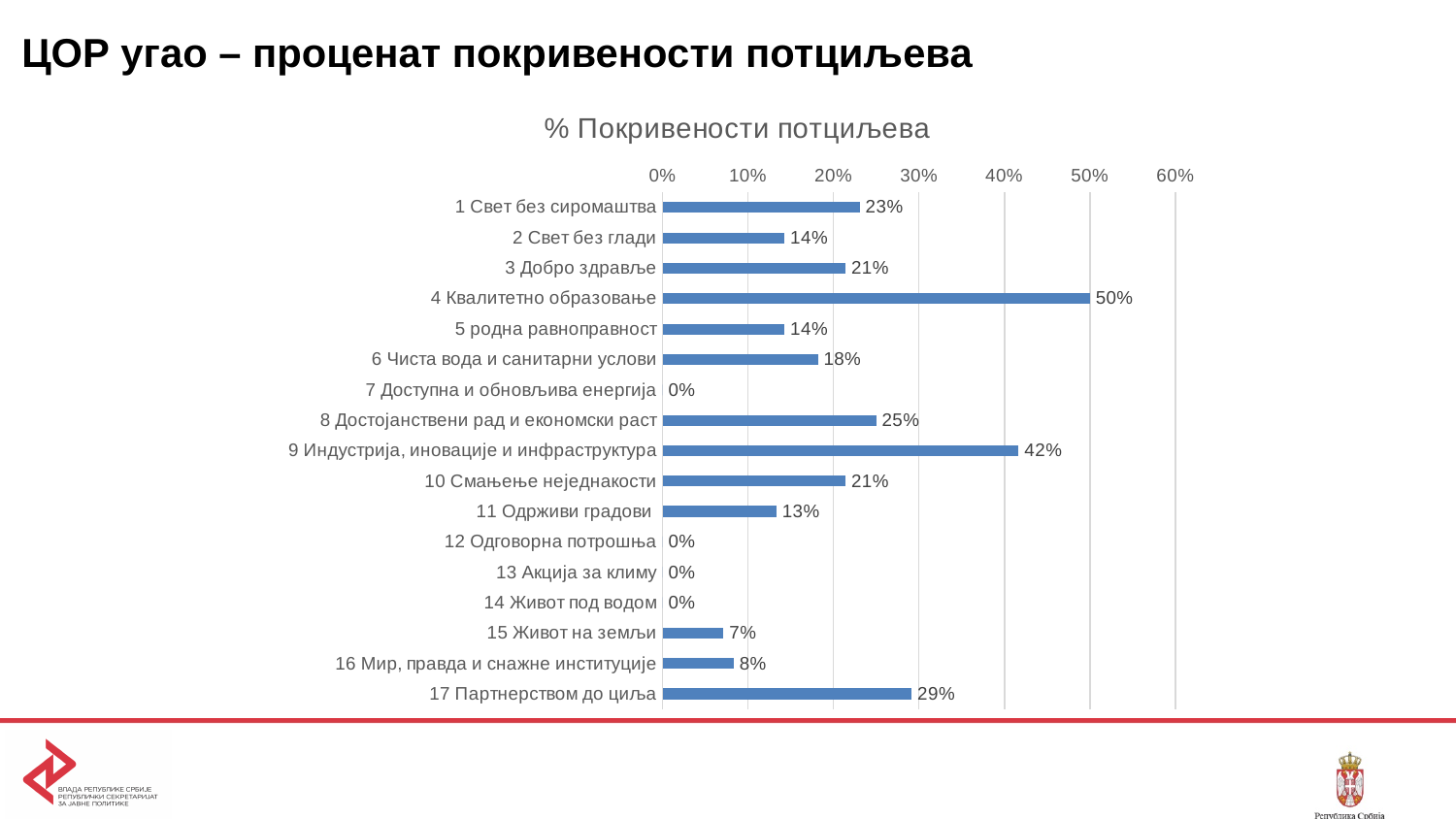
Which is larger, the value for 1 Свет без сиромаштва or the value for 8 Достојанствени рад и економски раст? 8 Достојанствени рад и економски раст What is the value for 17 Партнерством до циља? 29% Which category has the highest value? 4 Квалитетно образовање What is the difference between the values for 4 Квалитетно образовање and 9 Индустрија, иновације и инфраструктура? 8% How many categories have a value of 0%? 4 What is the value for 15 Живот на земљи? 7% What is the value for 4 Квалитетно образовање? 50% What is the title of the chart? % Покривености потциљева Is the value for 6 Чиста вода и санитарни услови greater or less than 20%? less What type of chart is shown on the slide? bar chart How many categories are plotted in the chart? 17 What is the value for 9 Индустрија, иновације и инфраструктура? 42%